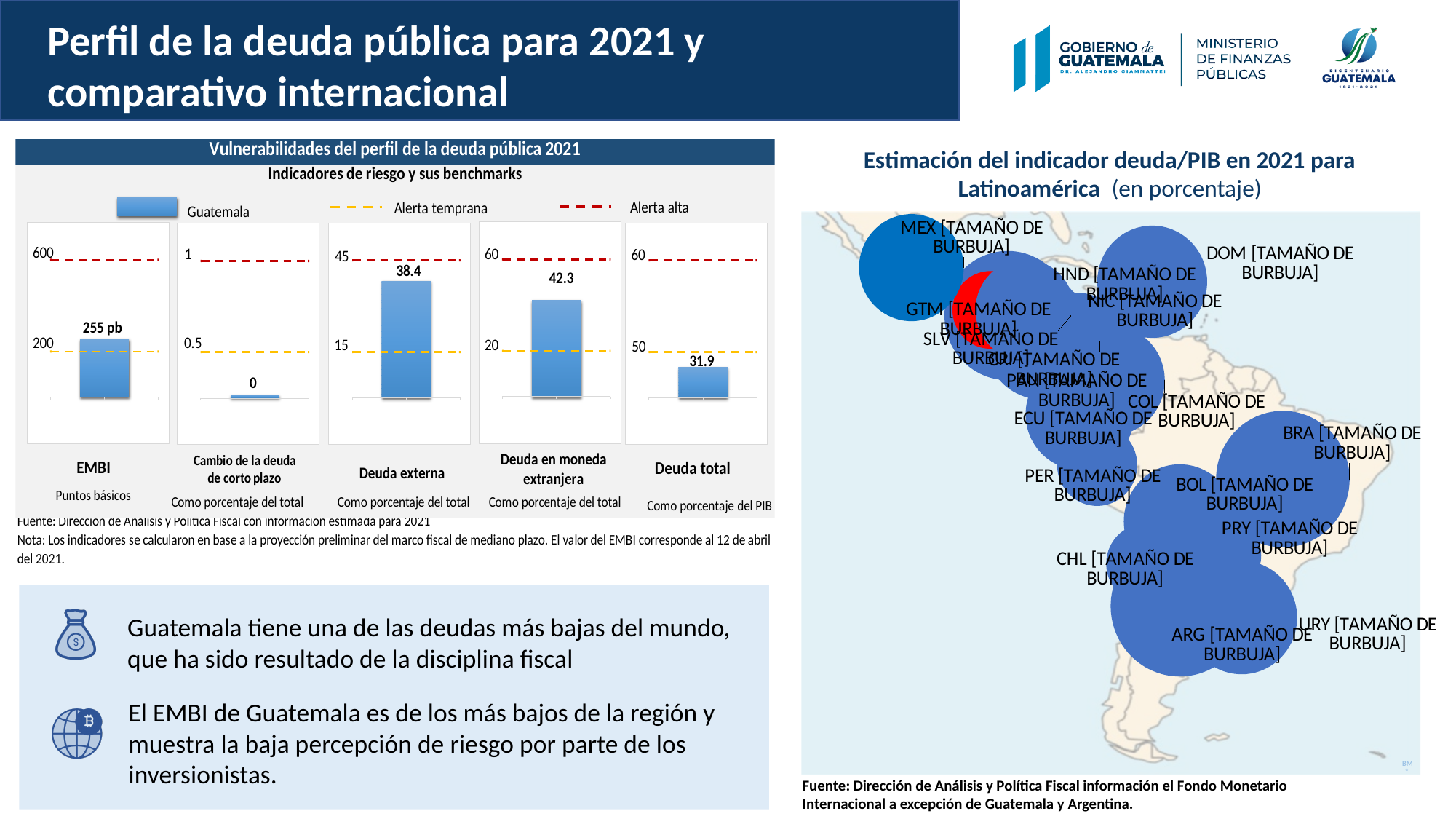
In the 'Vulnerabilidades del perfil de la deuda pública 2021' chart, what is the value shown for Deuda en moneda extranjera? 42.3 In the 'Vulnerabilidades del perfil de la deuda pública 2021' chart, is the Deuda total value greater or less than 50? less In the 'Vulnerabilidades del perfil de la deuda pública 2021' chart, what does the red dashed line represent according to the legend? Alerta alta In the 'Vulnerabilidades del perfil de la deuda pública 2021' chart, is the EMBI value greater or less than 200? greater In the 'Vulnerabilidades del perfil de la deuda pública 2021' chart, which is larger, Deuda externa or Deuda total? Deuda externa In the 'Vulnerabilidades del perfil de la deuda pública 2021' chart, what is the difference between Deuda en moneda extranjera and Deuda externa? 3.9 In the 'Vulnerabilidades del perfil de la deuda pública 2021' chart, what is the value shown for EMBI? 255 pb In the 'Vulnerabilidades del perfil de la deuda pública 2021' chart, what is the value shown for Deuda total? 31.9 How many risk indicators are shown in the 'Vulnerabilidades del perfil de la deuda pública 2021' chart? 5 In the 'Vulnerabilidades del perfil de la deuda pública 2021' chart, what is the value shown for Deuda externa? 38.4 In the 'Vulnerabilidades del perfil de la deuda pública 2021' chart, what is the value shown for Cambio de la deuda de corto plazo? 0 What type of chart is used for the 'Vulnerabilidades del perfil de la deuda pública 2021' indicators? Bar chart